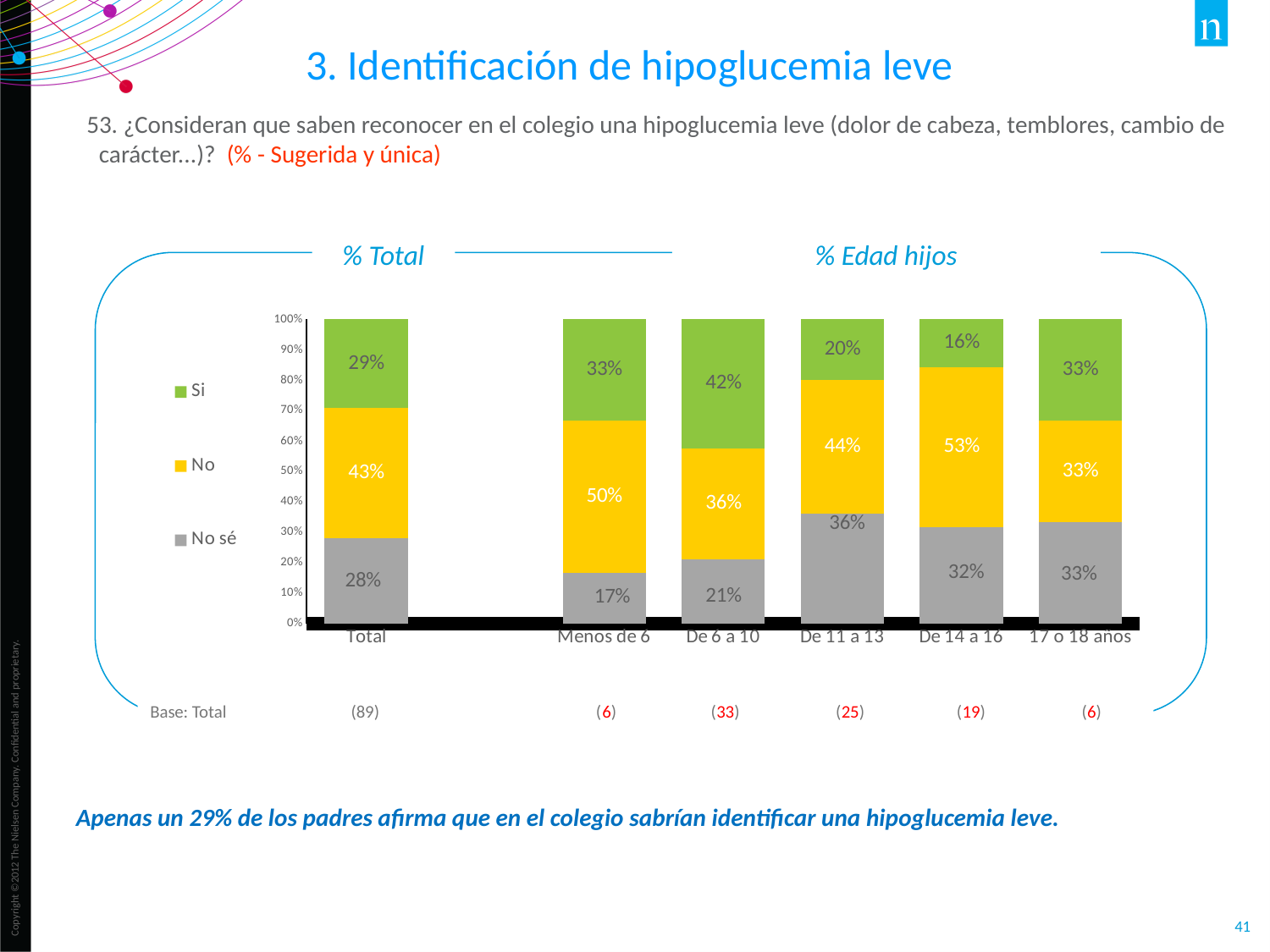
Which category has the lowest value for "Si"? De 14 a 16 What is the difference between the "No" value for De 14 a 16 and the "No" value for De 6 a 10? 17% Which category has the highest value for "Si"? De 6 a 10 What is the value of "No sé" for the Menos de 6 category? 17% How many series does the legend list? 3 What is the value of "No" for the De 14 a 16 category? 53% Which series is shown in green in the legend? Si Which is larger: the "No sé" value for De 11 a 13 or the "No sé" value for De 6 a 10? De 11 a 13 What type of chart is shown on the slide? Stacked bar chart What is the value of "Si" for the Total category? 29% How many categories are shown along the x axis? 6